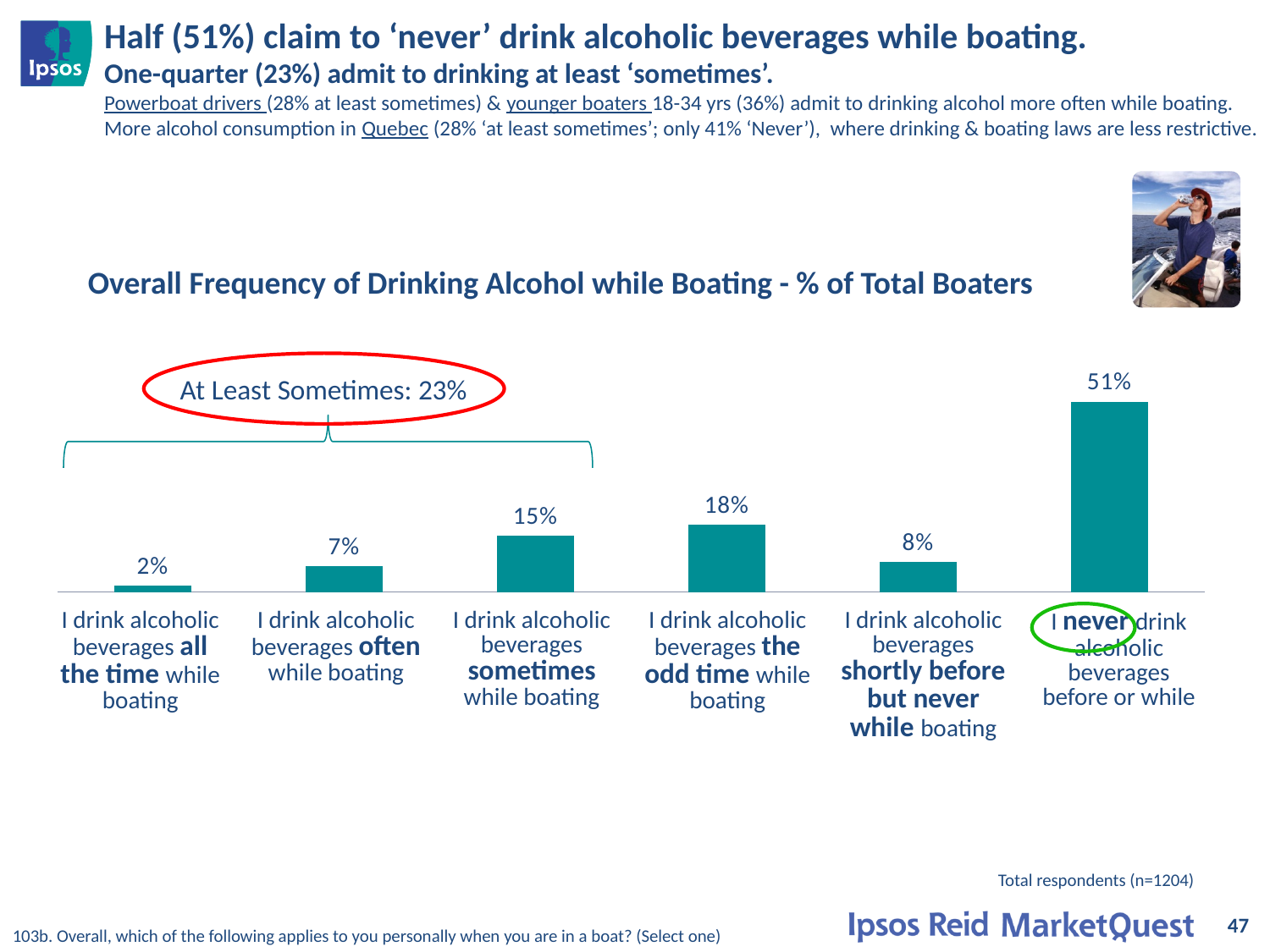
How many categories are shown in the chart? 6 Which is larger: the percentage for 'sometimes' or for 'shortly before but never while boating'? sometimes What is the difference in percentage points between 'the odd time' and 'often'? 11 Which category has the highest percentage of total boaters? I never drink alcoholic beverages before or while boating Which category has the lowest percentage of total boaters? I drink alcoholic beverages all the time while boating What is the title of the chart? Overall Frequency of Drinking Alcohol while Boating - % of Total Boaters What combined percentage is shown in the red oval for 'At Least Sometimes'? 23% What percentage of boaters say they never drink alcoholic beverages before or while boating? 51% What type of chart is shown on the slide? bar chart What percentage of boaters say they drink alcoholic beverages all the time while boating? 2% What percentage of boaters say they drink alcoholic beverages sometimes while boating? 15% What percentage of boaters say they drink alcoholic beverages shortly before but never while boating? 8%